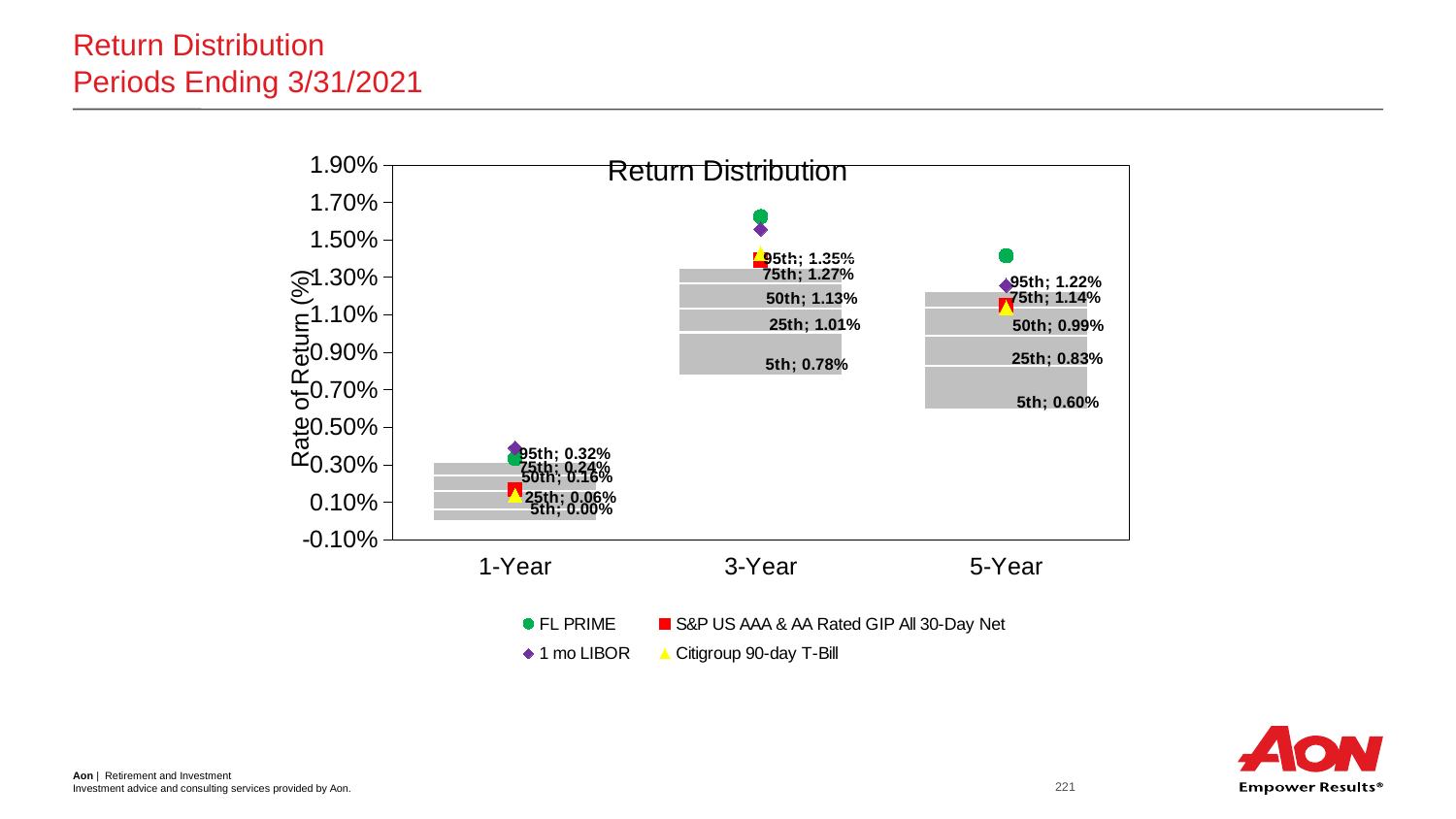
What is the 50th percentile return for the 5-Year period? 0.99% How many series does the legend list? 4 What is the 5th percentile return for the 1-Year period? 0.00% What is the 75th percentile return for the 5-Year period? 1.14% Which is larger: the 5th percentile return for the 3-Year period or the 5th percentile return for the 5-Year period? 3-Year Which period has the lowest 95th percentile return? 1-Year What is the 95th percentile return for the 3-Year period? 1.35% Which period has the highest 50th percentile return? 3-Year What is the 25th percentile return for the 3-Year period? 1.01% How many periods are shown on the x axis? 3 What is the difference between the 95th percentile return for the 3-Year period and the 95th percentile return for the 5-Year period? 0.13% Is the FL PRIME value for the 3-Year period greater or less than 1.50%? greater